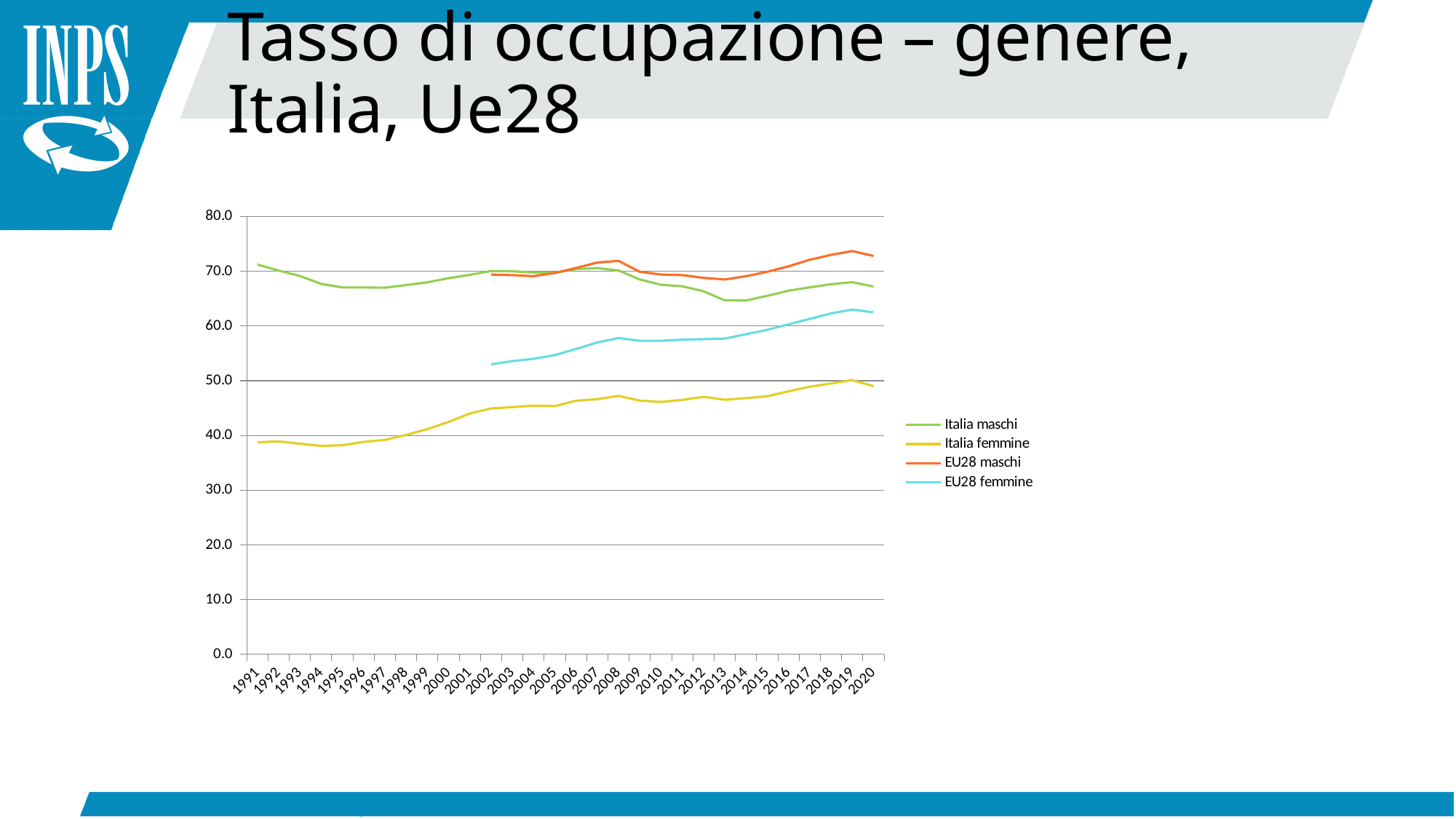
What kind of chart is shown on the slide? Line chart In 2020, which is larger: Italia femmine or EU28 femmine? EU28 femmine Is the value for Italia maschi in 1991 greater or less than 70? greater Is the value for EU28 femmine in 2019 greater or less than 60? greater How many series does the legend list? 4 Which series has the lowest value in 2020? Italia femmine Which series has the highest value in 2020? EU28 maschi Is the value for EU28 femmine in 2002 greater or less than 50? greater How many years are shown on the x axis? 30 Does the Italia femmine line rise or fall overall from 1991 to 2020? Rise